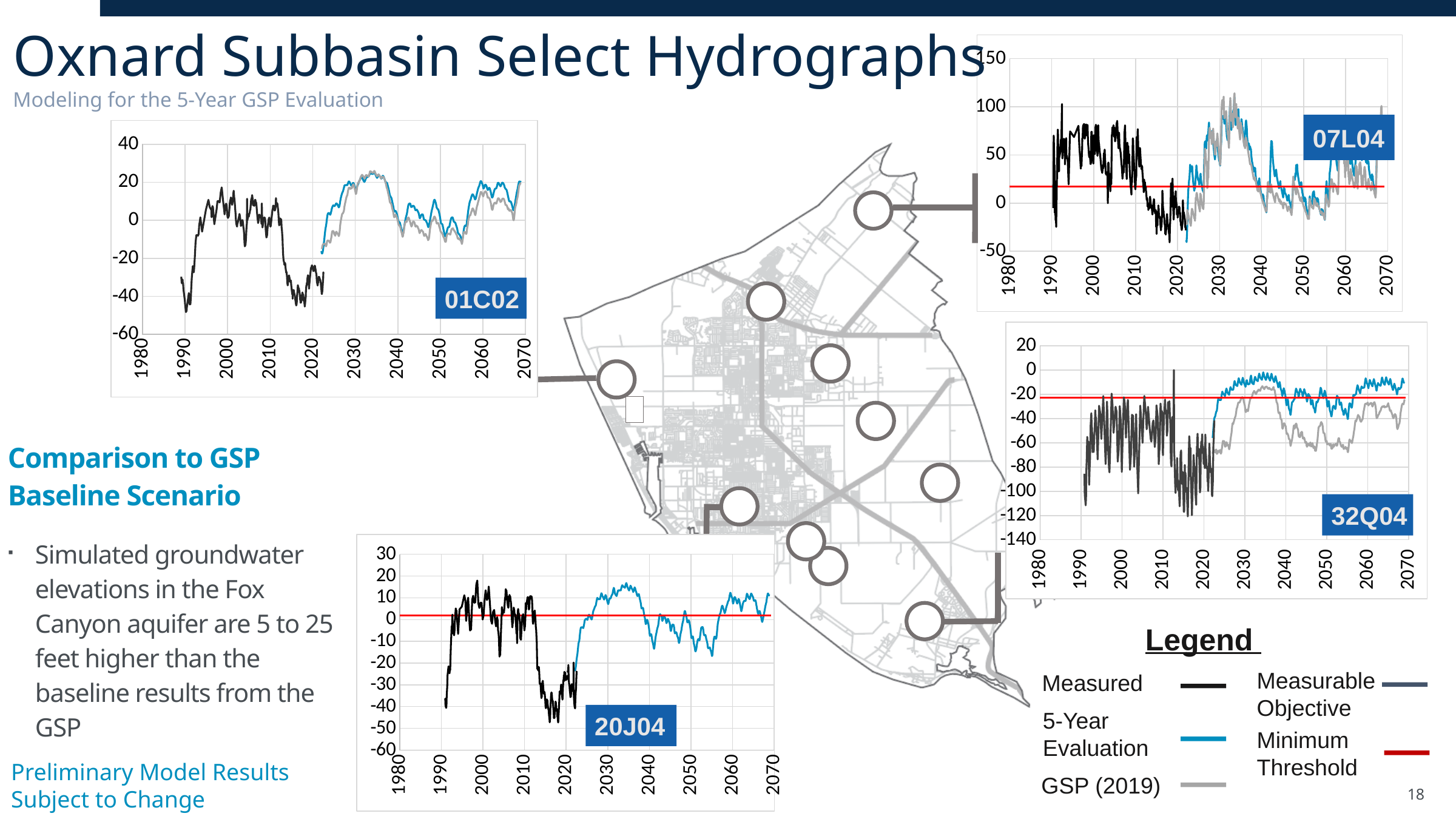
What colour is the Minimum Threshold line in the legend? red In the 01C02 chart, does the Measured line rise or fall between 2010 and 2015? fall In the 32Q04 chart, is the Measured value around 2015 greater or less than -60? less How many entries does the legend list? 5 In the 07L04 chart, is the Minimum Threshold line greater or less than 50? less In the 01C02 chart, is the Measured value around 2015 greater or less than -20? less What is the label of the chart in the top-right corner of the slide? 07L04 In the 20J04 chart, around 2035, which is higher: the 5-Year Evaluation line or the Minimum Threshold line? 5-Year Evaluation In the 32Q04 chart, around 2060, which line is higher: 5-Year Evaluation or GSP (2019)? 5-Year Evaluation What kind of chart is the 01C02 chart? line chart